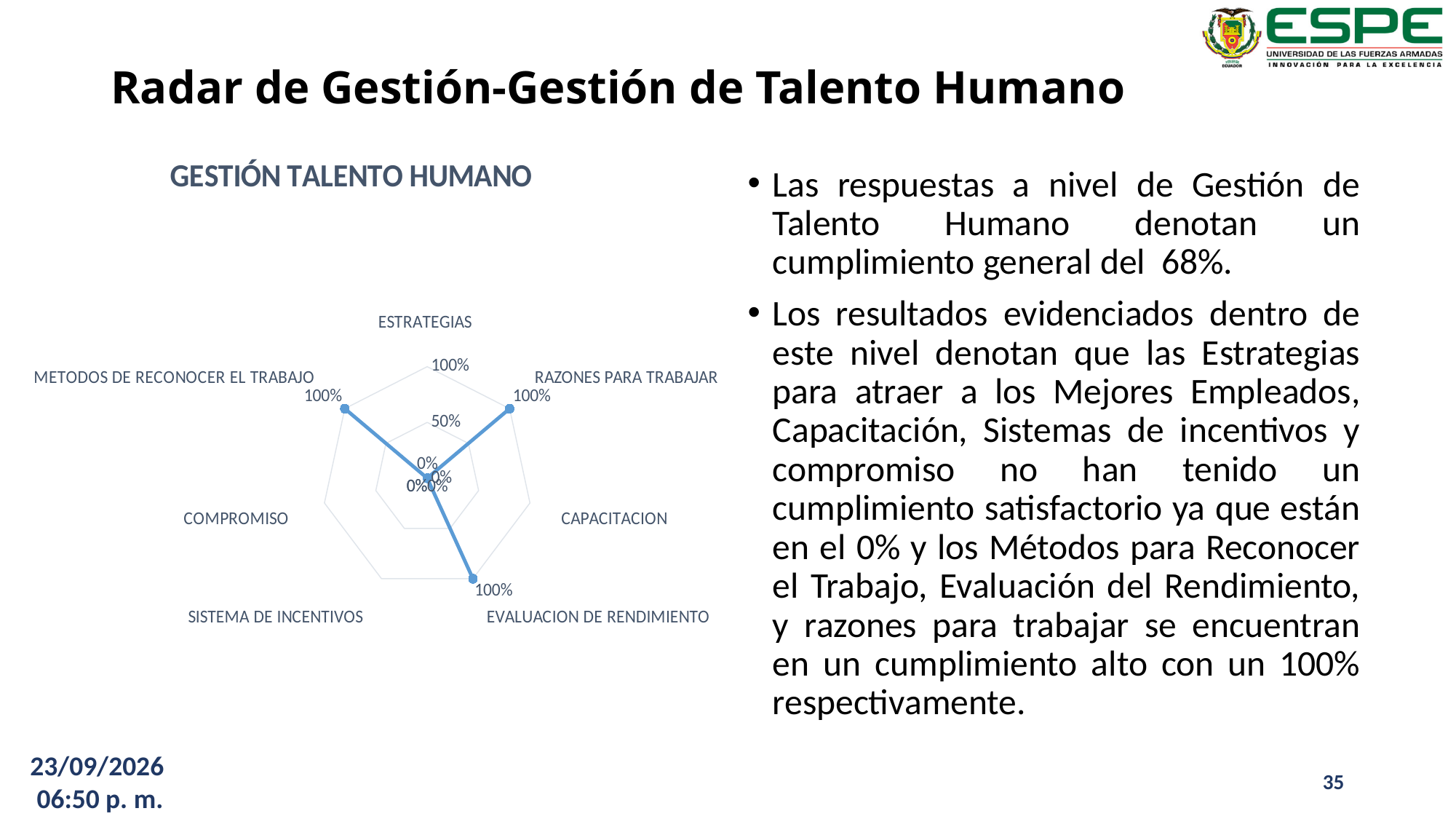
Is the value for METODOS DE RECONOCER EL TRABAJO greater or less than 50%? greater What is the value for CAPACITACION? 0% What kind of chart is shown on the slide? Radar chart What is the value for EVALUACION DE RENDIMIENTO? 100% What is the title of the chart? GESTIÓN TALENTO HUMANO Is the value for ESTRATEGIAS greater or less than 50%? less What is the value for METODOS DE RECONOCER EL TRABAJO? 100% Which is larger, the value for RAZONES PARA TRABAJAR or the value for COMPROMISO? RAZONES PARA TRABAJAR What is the value for RAZONES PARA TRABAJAR? 100% What is the difference between the value for EVALUACION DE RENDIMIENTO and the value for SISTEMA DE INCENTIVOS? 100% What is the highest value shown on the radar chart's axis scale? 100% How many categories are plotted on the radar chart? 7